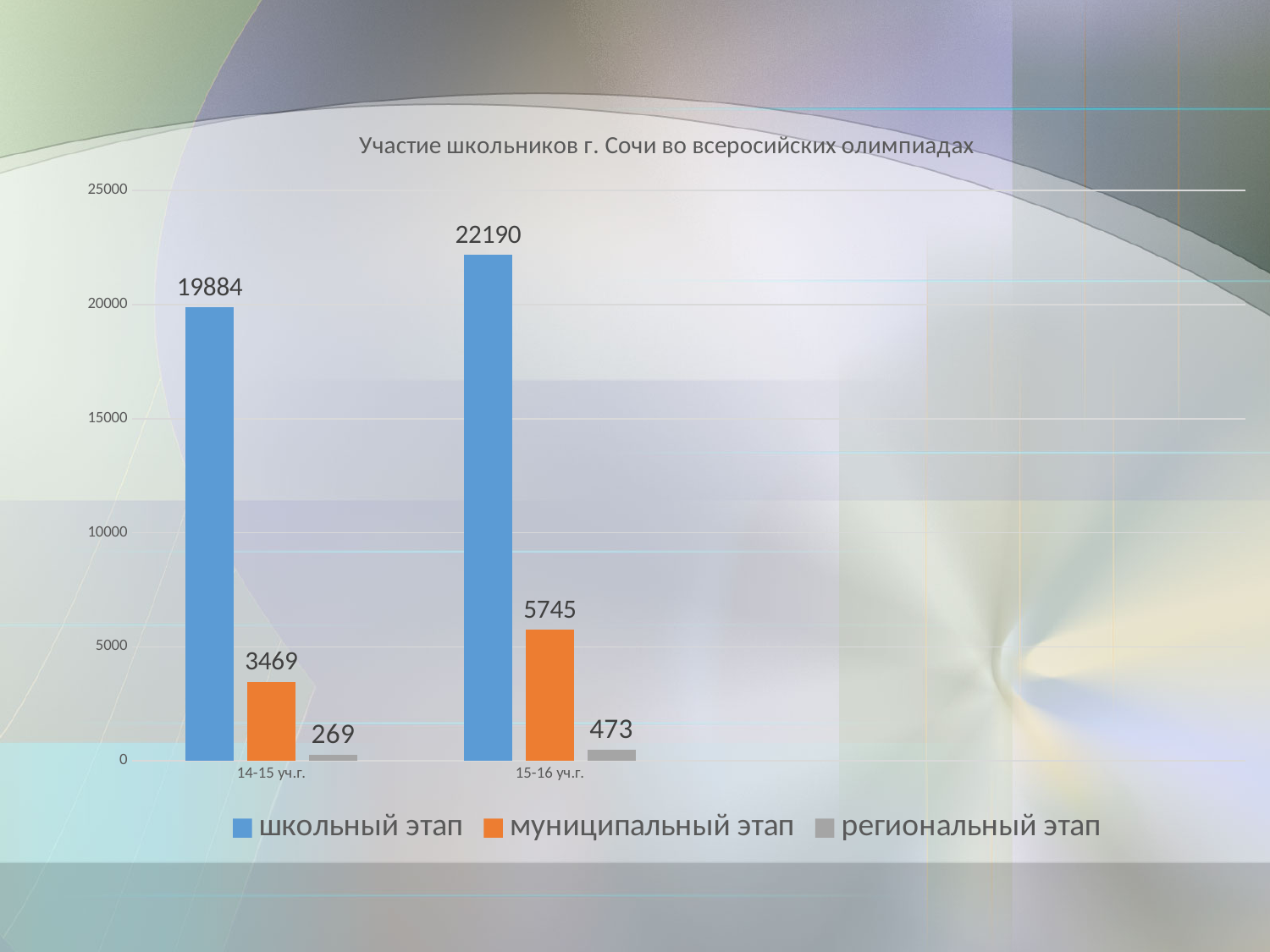
Which series has the highest value in 15-16 уч.г.? школьный этап How many series does the legend list? 3 What is the value for школьный этап in 15-16 уч.г.? 22190 What is the value for школьный этап in 14-15 уч.г.? 19884 What is the value for региональный этап in 14-15 уч.г.? 269 How many categories are shown on the x axis? 2 Which is larger: муниципальный этап in 14-15 уч.г. or муниципальный этап in 15-16 уч.г.? 15-16 уч.г. What is the difference between the региональный этап values for 15-16 уч.г. and 14-15 уч.г.? 204 What kind of chart is shown on the slide? bar chart What is the difference between the школьный этап values for 15-16 уч.г. and 14-15 уч.г.? 2306 Which series has the lowest value in 14-15 уч.г.? региональный этап What is the value for муниципальный этап in 15-16 уч.г.? 5745